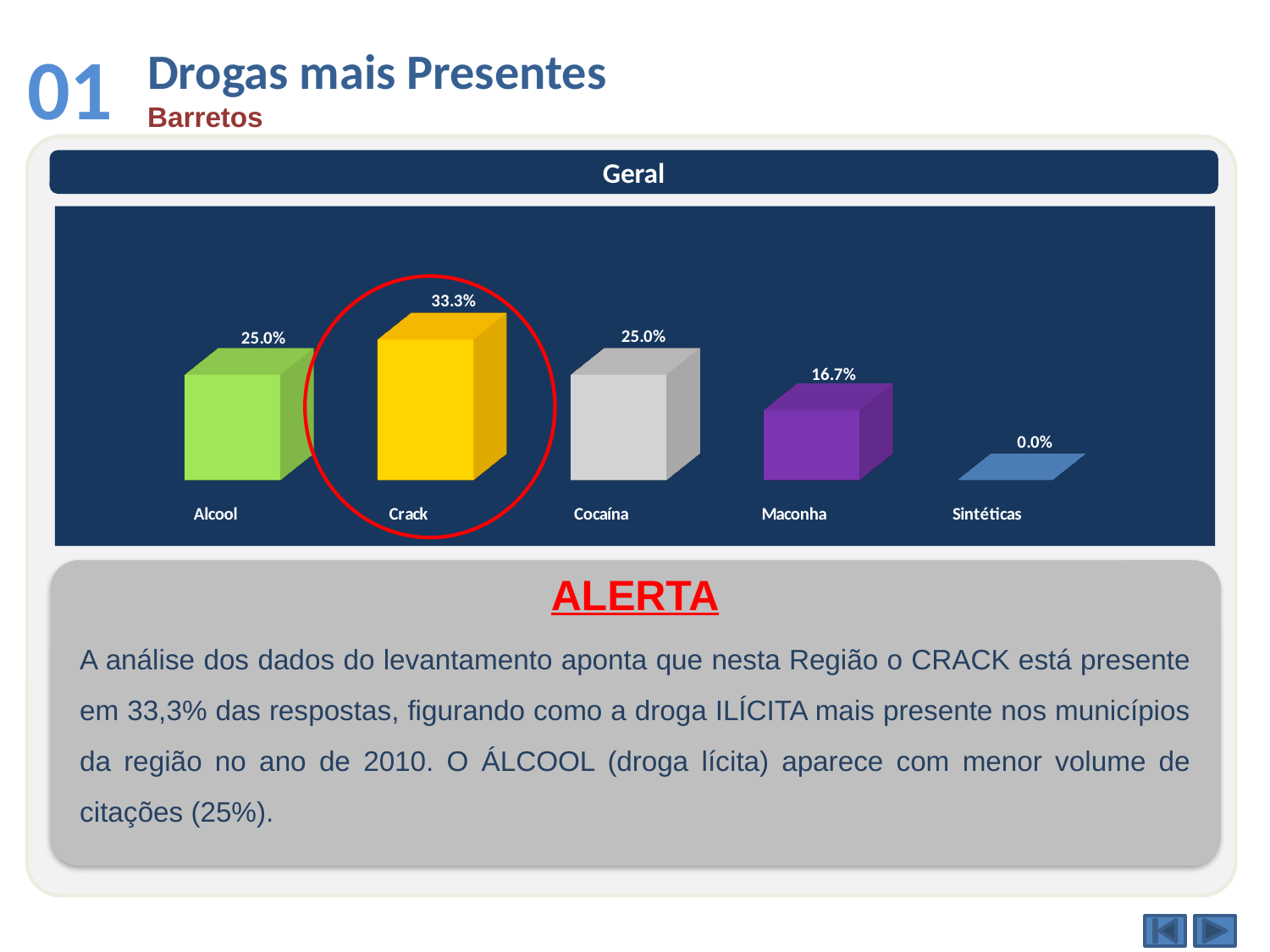
What is the value for Cocaína? 25.0% Which category has the highest value? Crack What is the value for Sintéticas? 0.0% What is the difference between the values for Alcool and Maconha? 8.3% What kind of chart is shown on the slide? Bar chart Which category has the lowest value? Sintéticas Which is larger, the value for Crack or the value for Cocaína? Crack What is the difference between the values for Crack and Maconha? 16.6% How many categories are shown on the chart? 5 What is the title shown above the chart? Geral What is the value for Maconha? 16.7% What is the value for Crack? 33.3%